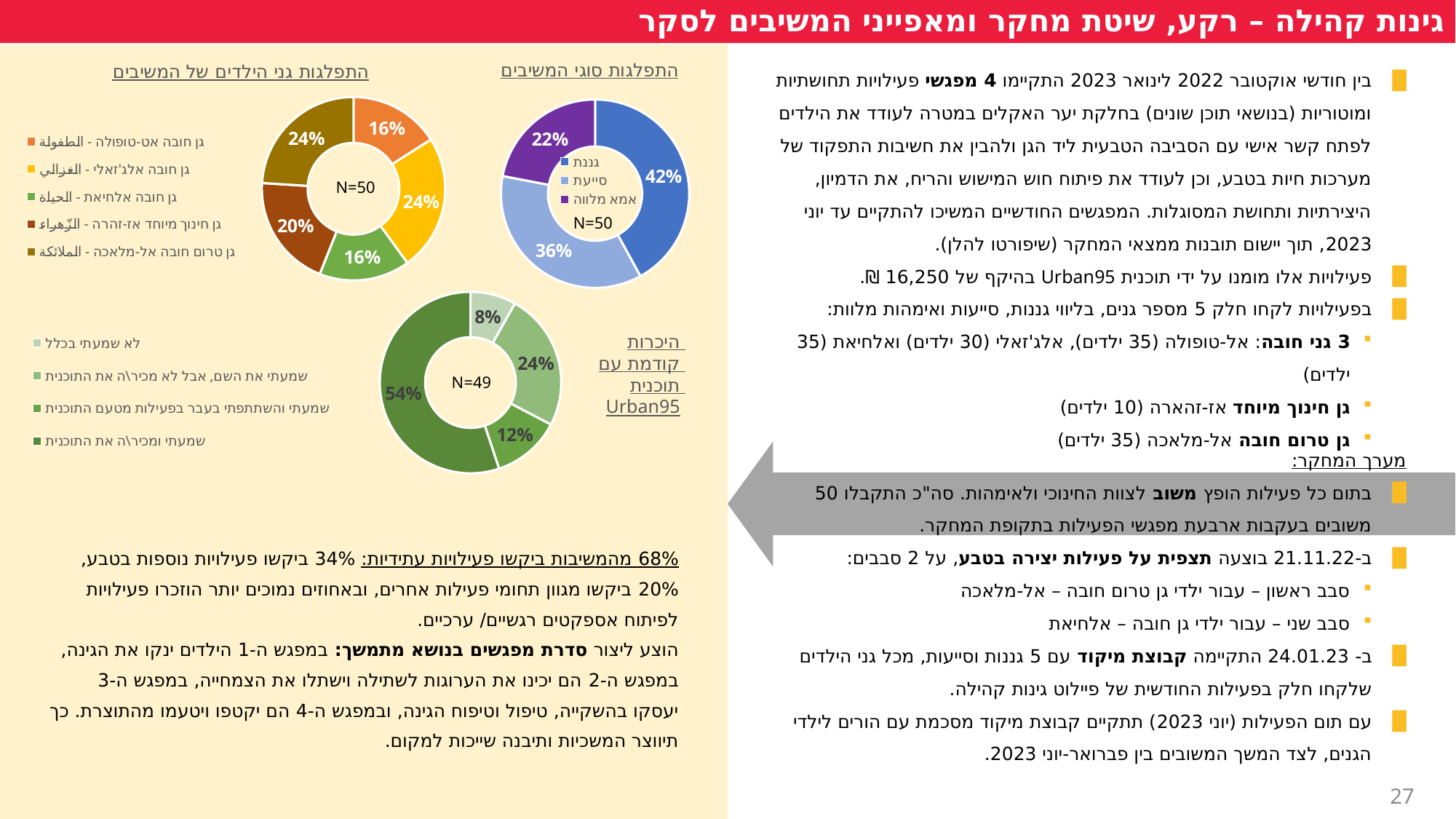
In the chart titled 'היכרות קודמת עם תוכנית Urban95', what is the N value shown in the centre of the donut? N=49 In the chart titled 'התפלגות סוגי המשיבים', which respondent type has the smallest share? אמא מלווה In the chart titled 'התפלגות גני הילדים של המשיבים', which is larger: the share for גן חובה אלג'זאלי or the share for גן חובה אלחיאת? גן חובה אלג'זאלי In the chart titled 'התפלגות גני הילדים של המשיבים', how many kindergartens are shown? 5 In the chart titled 'התפלגות סוגי המשיבים', what percentage of respondents are גננת (kindergarten teachers)? 42% In the chart titled 'התפלגות גני הילדים של המשיבים', what percentage of respondents are from גן חינוך מיוחד אז-זהרה? 20% In the chart titled 'היכרות קודמת עם תוכנית Urban95', what percentage of respondents answered 'שמעתי ומכיר/ה את התוכנית'? 54% In the chart titled 'התפלגות סוגי המשיבים', how many respondent types are shown in the legend? 3 In the chart titled 'היכרות קודמת עם תוכנית Urban95', which category has the smallest share? לא שמעתי בכלל What type of chart is used for 'היכרות קודמת עם תוכנית Urban95'? Donut (pie) chart In the chart titled 'התפלגות גני הילדים של המשיבים', what is the N value shown in the centre of the donut? N=50 In the chart titled 'התפלגות סוגי המשיבים', what is the difference in percentage points between גננת and סייעת? 6